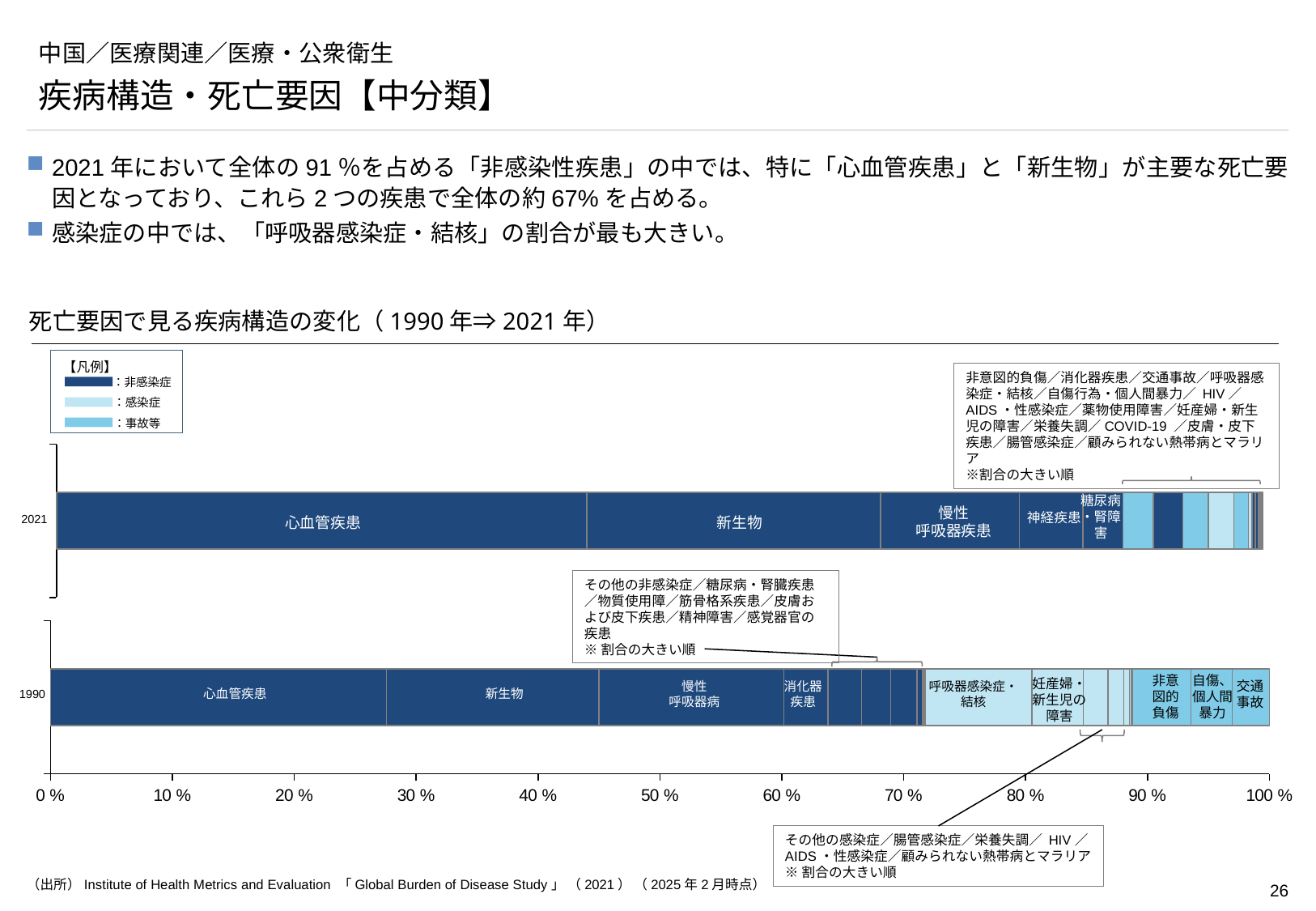
What is the title of the chart? 死亡要因で見る疾病構造の変化（1990年⇒2021年） How many years (bars) are plotted in the chart? 2 Is the share of 心血管疾患 in 1990 greater or less than 30%? less Which year has the larger share of 心血管疾患, 1990 or 2021? 2021 Which segment is the largest in the 2021 bar? 心血管疾患 Is the share of 慢性呼吸器病 in 1990 greater or less than 10%? greater Is the share of 心血管疾患 in 2021 greater or less than 40%? greater How many categories does the legend list? 3 What kind of chart is shown on the slide? Stacked bar chart Which segment is the largest in the 1990 bar? 心血管疾患 Which year has the larger share of 新生物, 1990 or 2021? 2021